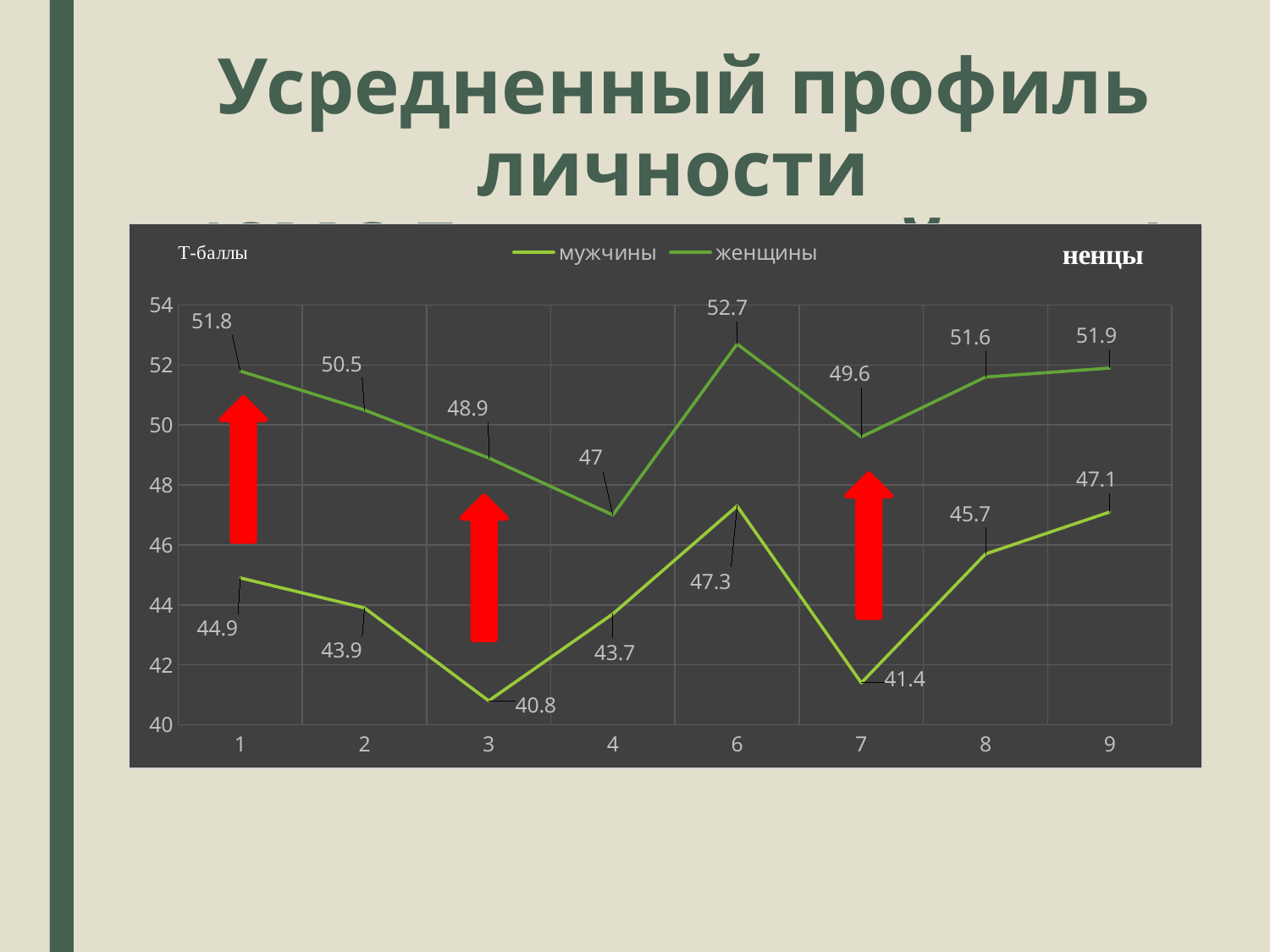
What is the difference between the женщины and мужчины values at category 1? 6.9 At which category does the женщины series reach its highest value? 6 Is the value for мужчины at category 6 greater or less than 46? greater At category 4, which series has the larger value, мужчины or женщины? женщины What are the two entries in the chart legend? мужчины, женщины How many series does the legend list? 2 Does the женщины series rise or fall from category 1 to category 4? fall How many categories are shown along the x axis? 8 What kind of chart is shown on the slide? line chart What is the value for женщины at category 6? 52.7 At which category does the мужчины series reach its lowest value? 3 What is the value for мужчины at category 3? 40.8